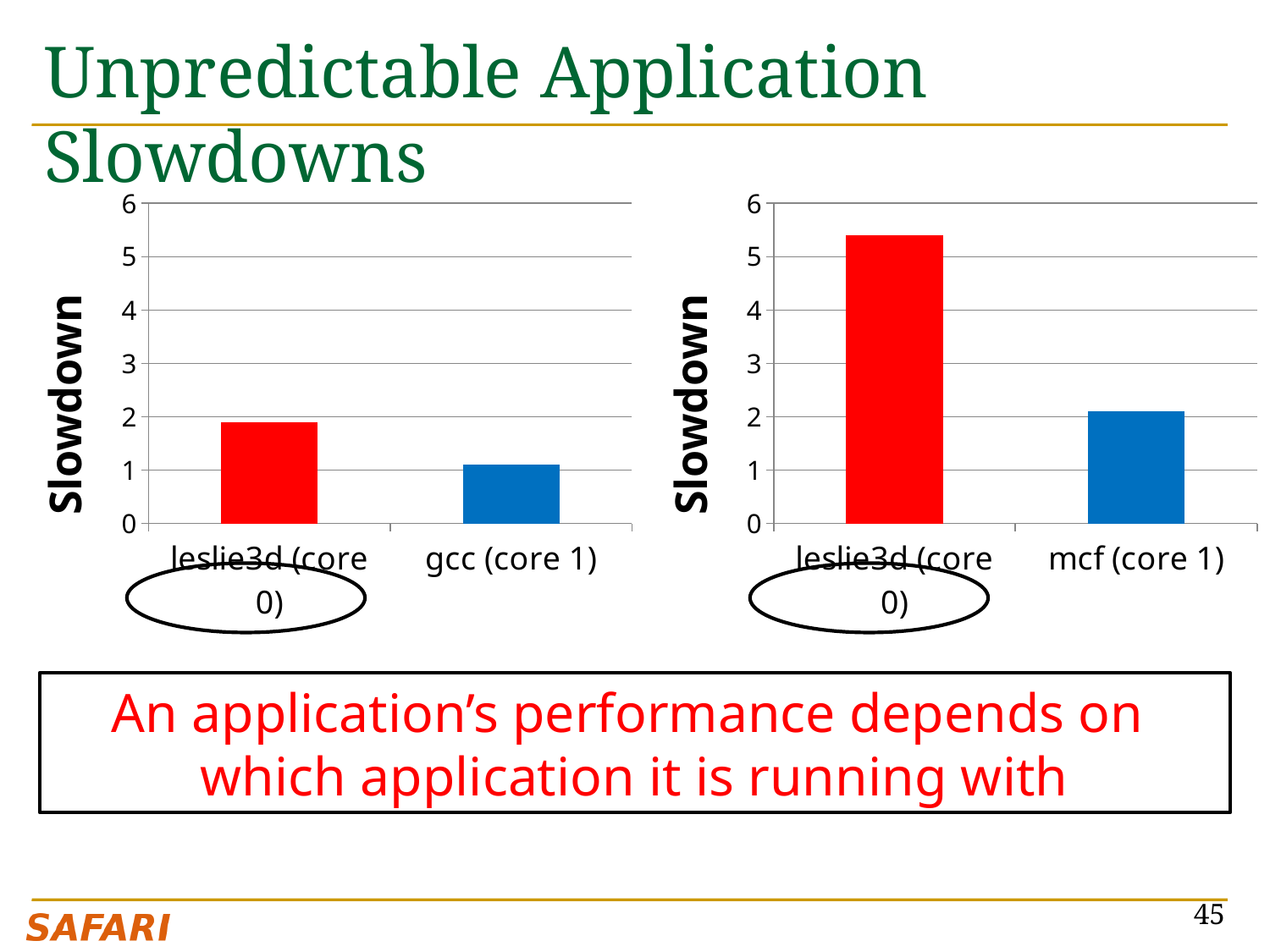
In the right chart, is the slowdown for leslie3d (core 0) greater or less than 4? greater How many categories are shown in the right chart? 2 Is the slowdown for leslie3d (core 0) larger in the left chart or in the right chart? right chart In the left chart, which category has the lowest slowdown? gcc (core 1) In the left chart, which category has the highest slowdown? leslie3d (core 0) In the right chart, is the slowdown for mcf (core 1) greater or less than 3? less What type of chart is the left chart on the slide? bar chart What is the y-axis label of the left chart? Slowdown In the right chart, which category has the highest slowdown? leslie3d (core 0) In the right chart, which category has the lowest slowdown? mcf (core 1) In the left chart, is the slowdown for leslie3d (core 0) greater or less than 1? greater